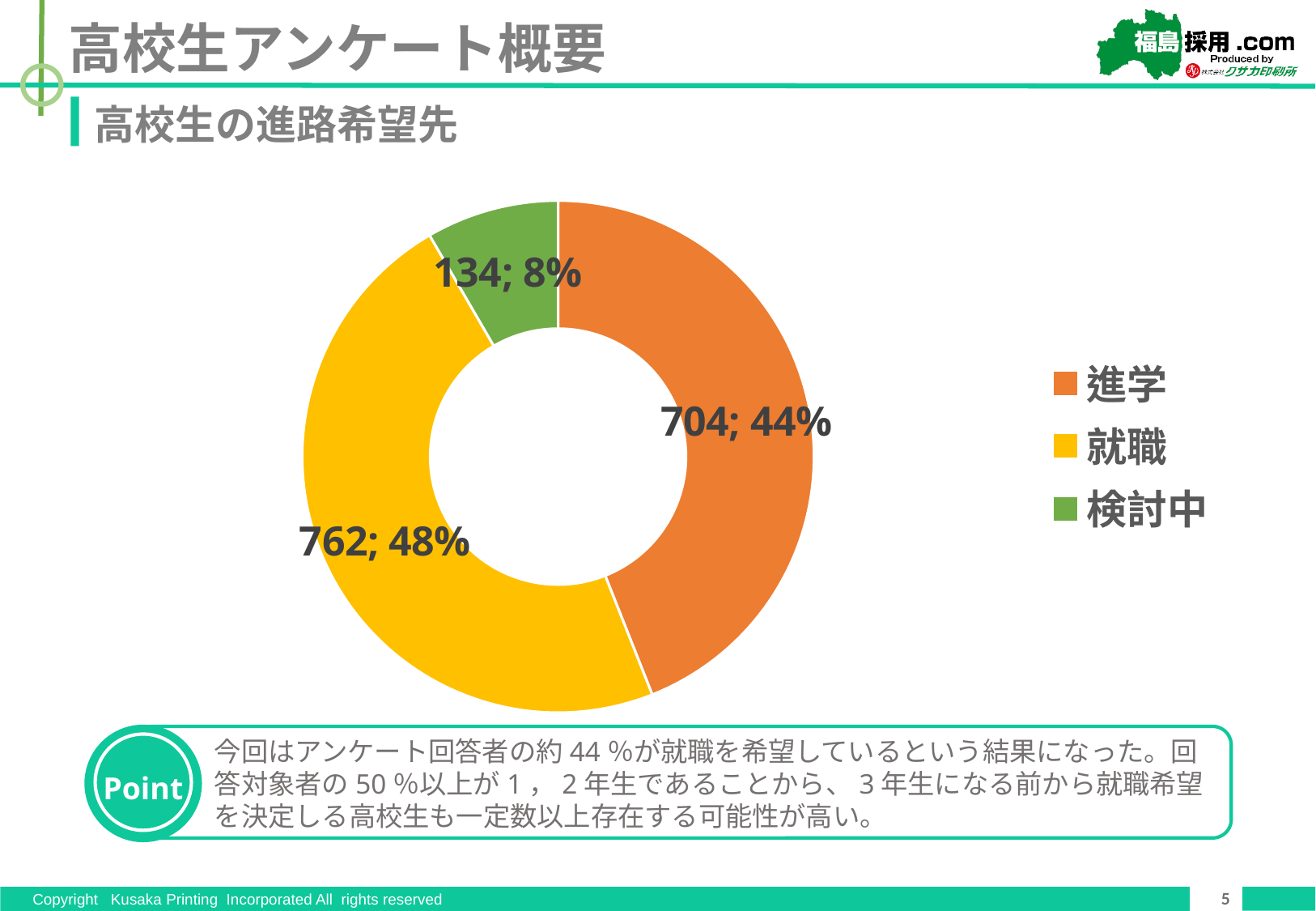
Which category has the largest slice? 就職 What colour is the slice for 就職? Yellow What is the difference between the counts for 就職 and 進学? 58 What share of the pie does 検討中 represent? 8% What is the value shown for 就職? 762; 48% What kind of chart is shown on the slide? Pie chart (donut) Which category has the smallest slice? 検討中 Which is larger, the value for 進学 or the value for 検討中? 進学 What is the value shown for 検討中? 134; 8% What is the total of all three slices? 1600 What is the value shown for 進学? 704; 44% How many categories does the pie chart show? 3